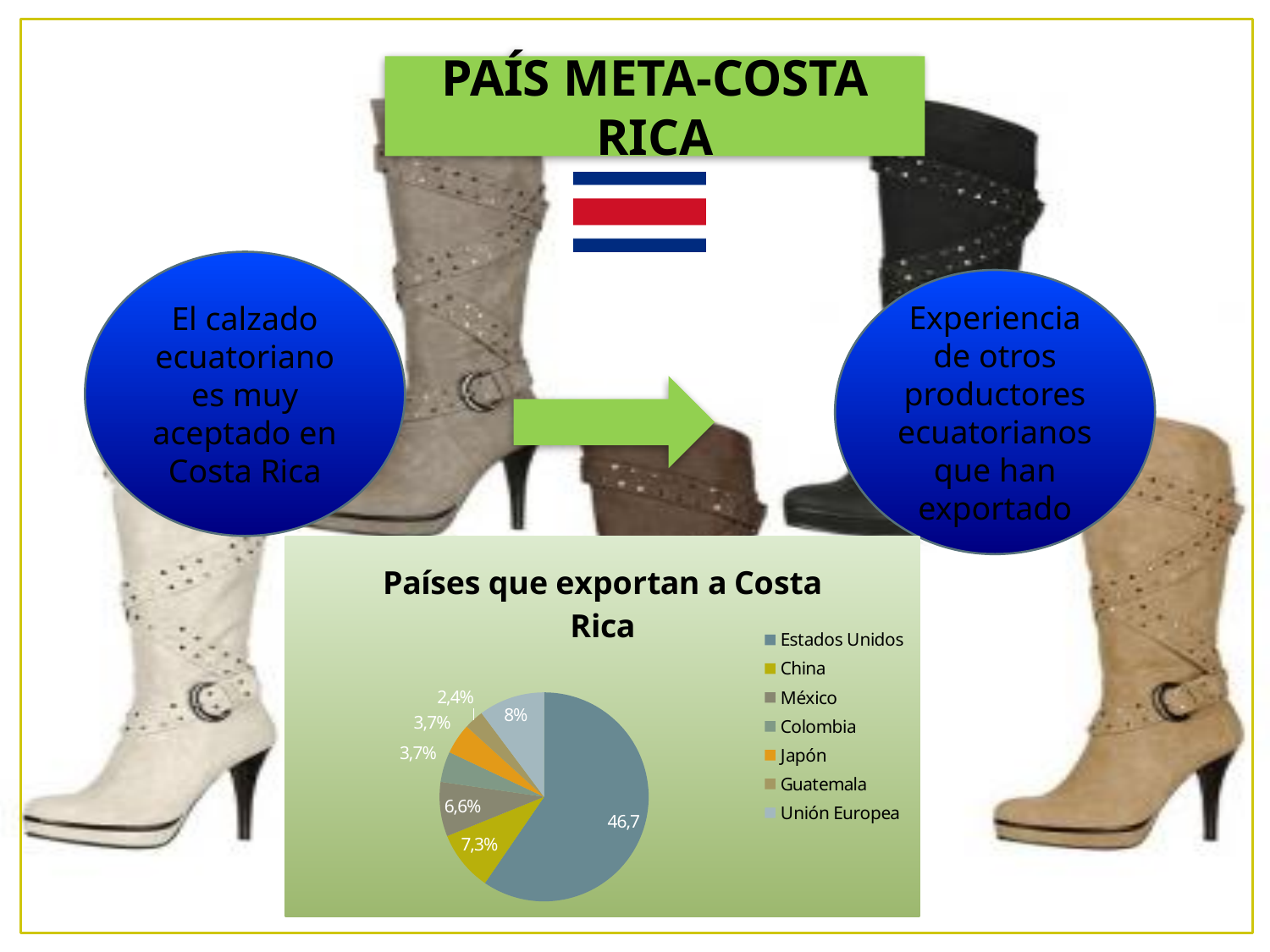
Which has a larger share, China or Unión Europea? Unión Europea How many entries does the chart legend list? 7 What share does Unión Europea have in the pie chart? 8% Which country has the smallest slice of the pie chart? Guatemala What is the difference between the shares of Unión Europea and Guatemala? 5,6% Which country has the largest slice of the pie chart? Estados Unidos What share does Guatemala have in the pie chart? 2,4% What kind of chart is shown on the slide? pie chart What share does México have in the pie chart? 6,6% What share does China have in the pie chart? 7,3% What value is shown for Estados Unidos in the pie chart? 46,7 What is the title of the chart? Países que exportan a Costa Rica